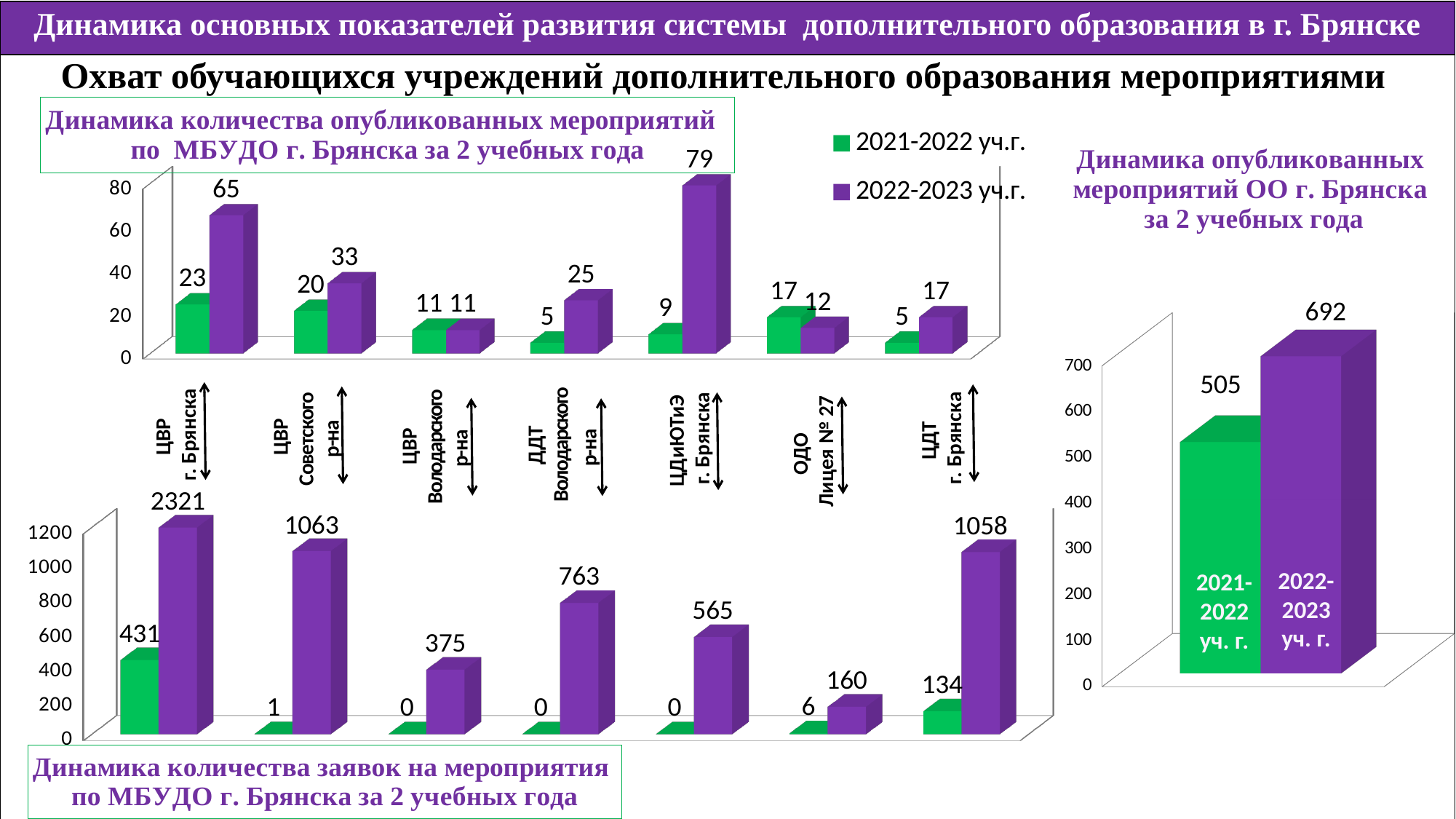
Сколько учреждений показано на диаграмме «Динамика количества заявок на мероприятия по МБУДО г. Брянска за 2 учебных года»? 7 На диаграмме «Динамика количества опубликованных мероприятий по МБУДО г. Брянска за 2 учебных года» сколько мероприятий опубликовал ЦДиЮТиЭ г. Брянска в 2022-2023 уч.г.? 79 На диаграмме «Динамика количества заявок на мероприятия по МБУДО г. Брянска за 2 учебных года» сколько заявок у ЦВР г. Брянска за 2022-2023 уч.г.? 2321 На диаграмме «Динамика количества опубликованных мероприятий по МБУДО г. Брянска за 2 учебных года» у какого учреждения наибольшее значение за 2022-2023 уч.г.? ЦДиЮТиЭ г. Брянска На диаграмме «Динамика количества опубликованных мероприятий по МБУДО г. Брянска за 2 учебных года» у ОДО Лицея № 27 значение за 2021-2022 уч.г. больше или меньше, чем за 2022-2023 уч.г.? больше На диаграмме «Динамика количества заявок на мероприятия по МБУДО г. Брянска за 2 учебных года» какое значение у ЦДТ г. Брянска за 2021-2022 уч.г.? 134 Сколько серий указано в легенде диаграммы «Динамика количества опубликованных мероприятий по МБУДО г. Брянска за 2 учебных года»? 2 На диаграмме «Динамика количества заявок на мероприятия по МБУДО г. Брянска за 2 учебных года» у какого учреждения наименьшее значение за 2022-2023 уч.г.? ОДО Лицея № 27 На диаграмме «Динамика опубликованных мероприятий ОО г. Брянска за 2 учебных года» на сколько значение 2022-2023 уч. г. больше значения 2021-2022 уч. г.? 187 На диаграмме «Динамика количества опубликованных мероприятий по МБУДО г. Брянска за 2 учебных года» какое значение у ЦВР Советского р-на за 2021-2022 уч.г.? 20 Какого типа диаграмма «Динамика опубликованных мероприятий ОО г. Брянска за 2 учебных года»? столбчатая (bar chart) На диаграмме «Динамика количества опубликованных мероприятий по МБУДО г. Брянска за 2 учебных года» на сколько выросло значение ЦВР г. Брянска с 2021-2022 по 2022-2023 уч.г.? 42